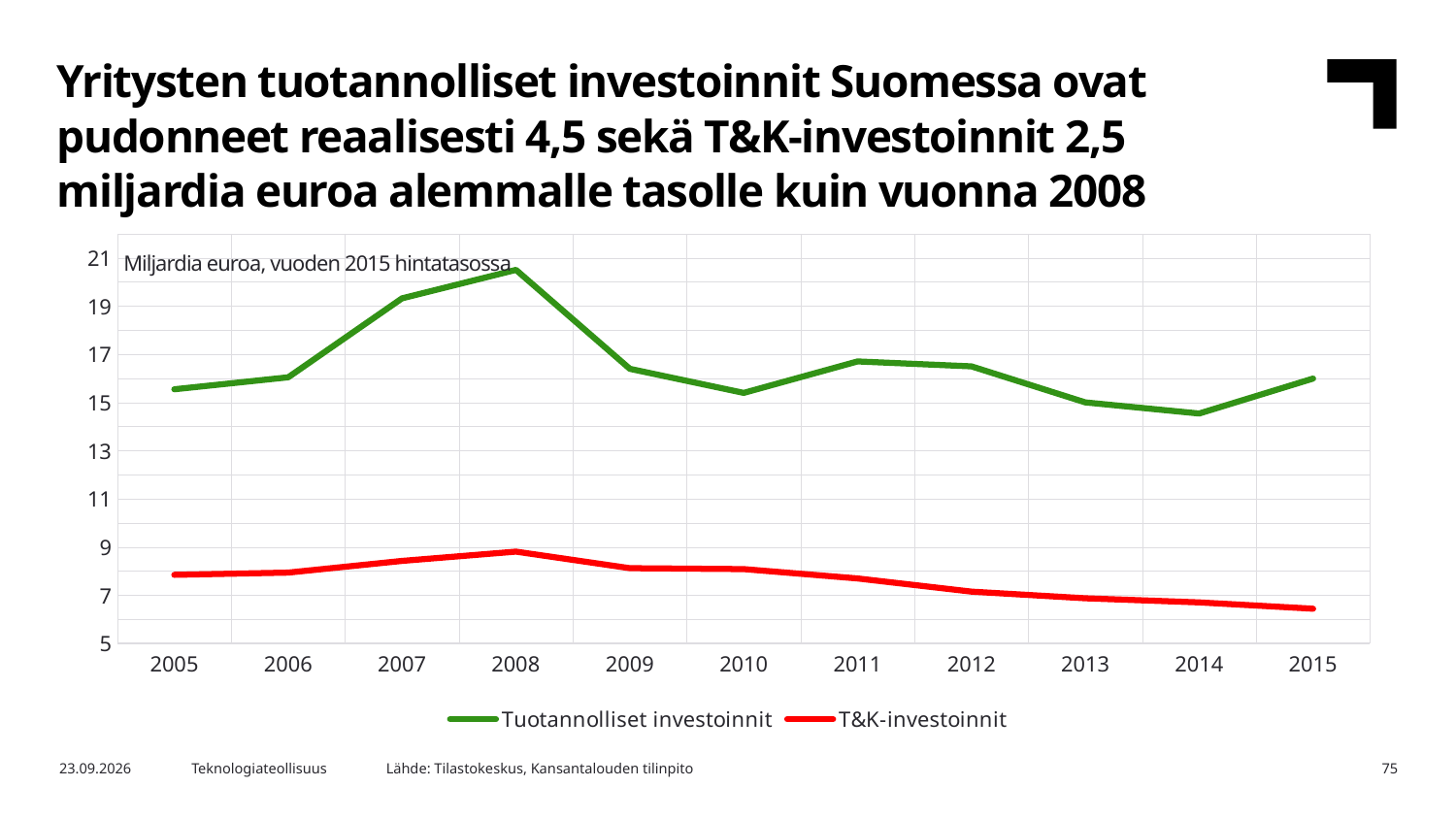
Is the value for Tuotannolliset investoinnit in 2008 greater or less than 19? greater In which year is the value for T&K-investoinnit highest? 2008 In which year is the value for T&K-investoinnit lowest? 2015 Which is larger for Tuotannolliset investoinnit: the value in 2008 or the value in 2010? 2008 What kind of chart is shown on the slide? Line chart In which year is the value for Tuotannolliset investoinnit highest? 2008 Which colour is used for the T&K-investoinnit line? Red Is the value for T&K-investoinnit in 2015 greater or less than 7? less How many series does the legend list? 2 Does the T&K-investoinnit line rise or fall from 2008 to 2015? Fall How many years are shown on the x axis? 11 Is the value for Tuotannolliset investoinnit in 2014 greater or less than 17? less